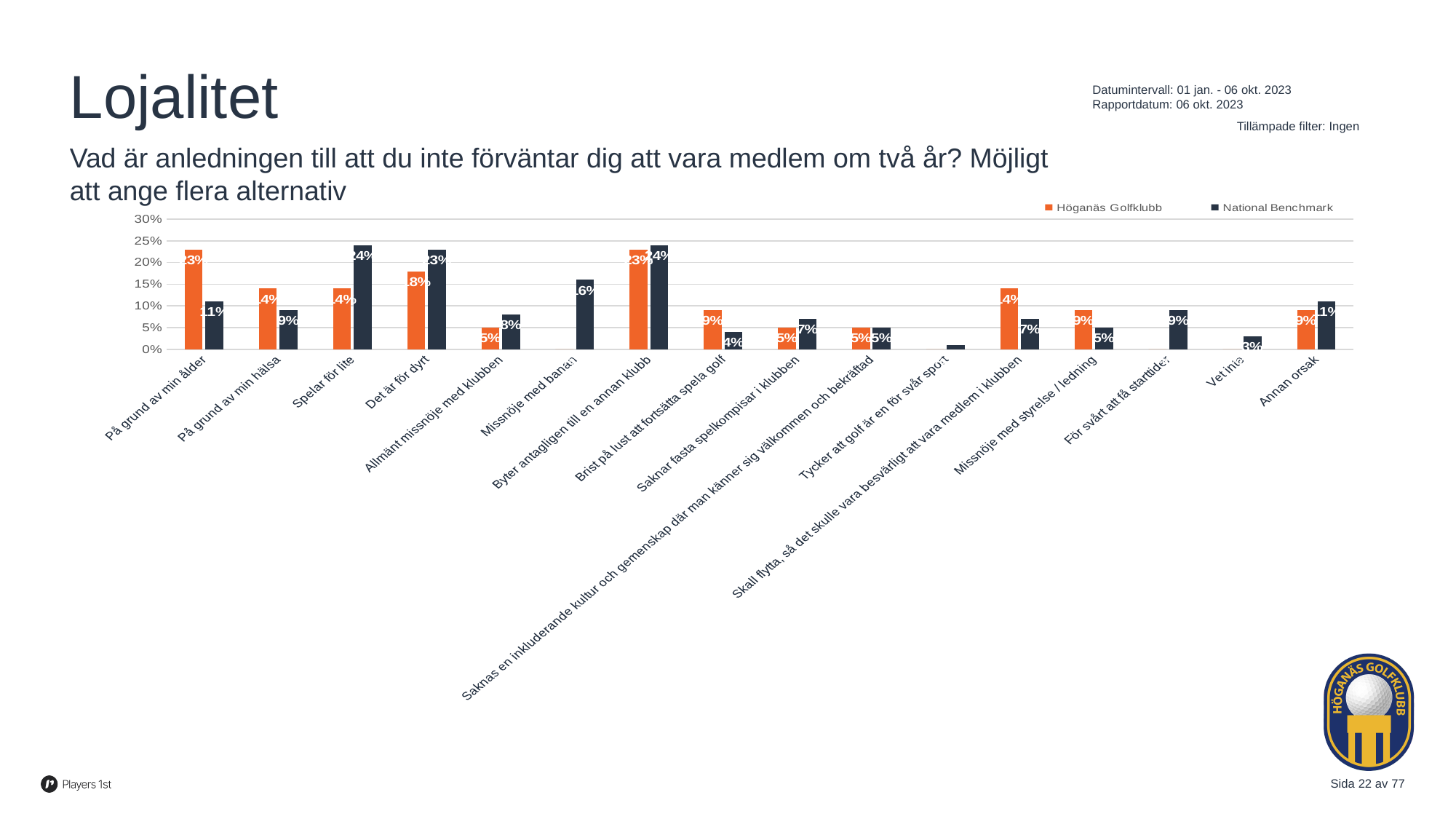
What kind of chart is shown on the slide? bar chart For 'Spelar för lite', which series has the larger value, Höganäs Golfklubb or National Benchmark? National Benchmark For 'Skall flytta, så det skulle vara besvärligt att vara medlem i klubben', which series has the larger value? Höganäs Golfklubb How many categories are shown on the x axis? 16 What is the National Benchmark value for 'Spelar för lite'? 24% What is the Höganäs Golfklubb value for 'Det är för dyrt'? 18% What is the National Benchmark value for 'Missnöje med banan'? 16% Which series is shown in orange in the legend? Höganäs Golfklubb Which category has the lowest National Benchmark value? Tycker att golf är en för svår sport How many series does the legend list? 2 What is the difference between the Höganäs Golfklubb and National Benchmark values for 'På grund av min ålder'? 12 percentage points What is the National Benchmark value for 'Vet inte'? 3%